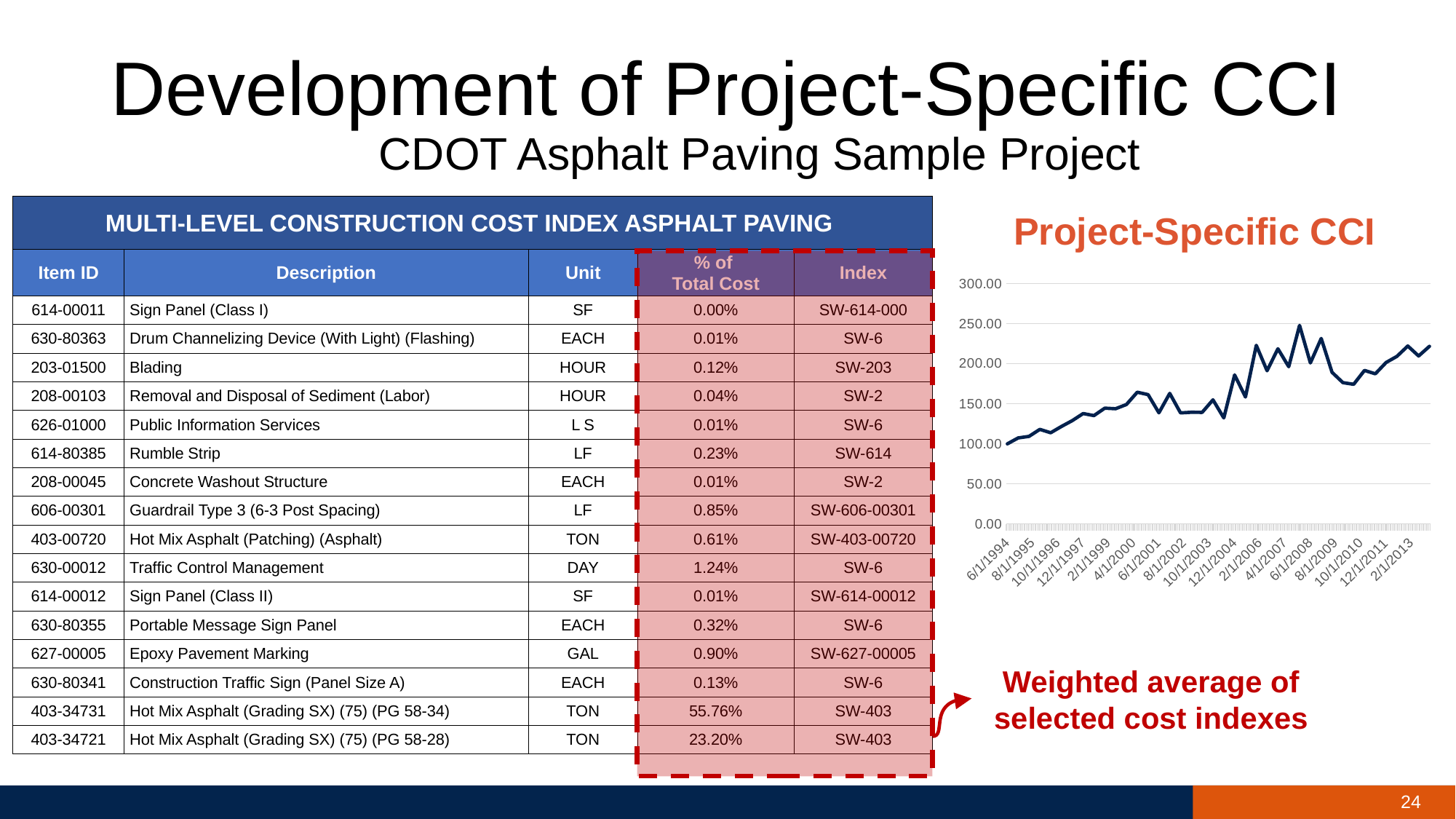
What kind of chart is the Project-Specific CCI chart? line chart In the Project-Specific CCI chart, which is larger: the value at 8/1/2009 or the value at 6/1/2001? 8/1/2009 In the Project-Specific CCI chart, does the line overall rise or fall from 6/1/1994 to 2/1/2013? rise In the Project-Specific CCI chart, is the value at 10/1/2003 greater or less than 200? less What is the title of the chart on the right side of the slide? Project-Specific CCI In the Project-Specific CCI chart, is the value at 2/1/2013 greater or less than 200? greater In the Project-Specific CCI chart, is the value at 8/1/2009 greater or less than 200? less In the Project-Specific CCI chart, which is larger: the value at 6/1/1994 or the value at 2/1/2013? 2/1/2013 What is the highest value shown on the y axis of the Project-Specific CCI chart? 300.00 How many date labels are shown on the x axis of the Project-Specific CCI chart? 17